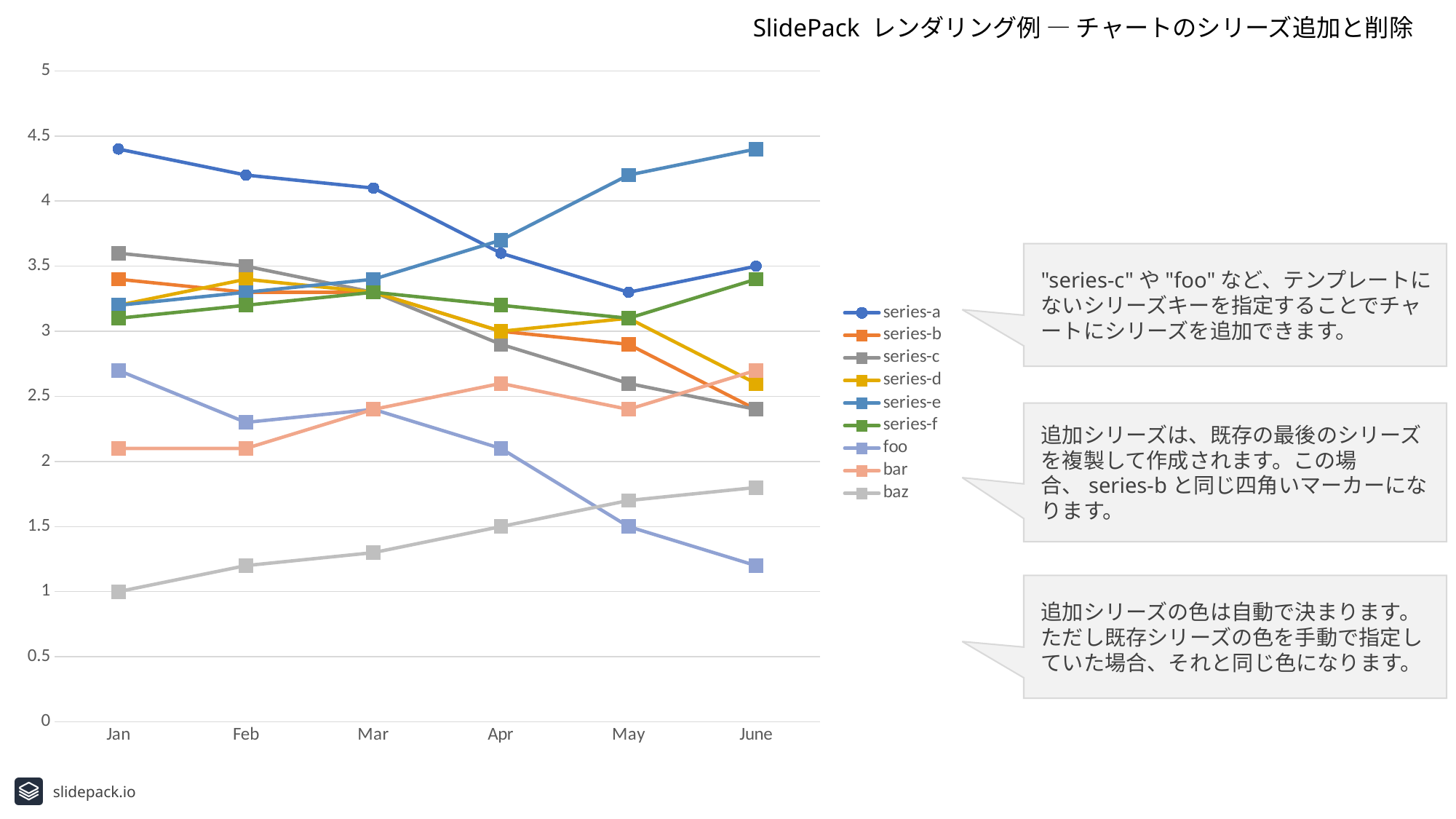
How many series does the legend list? 9 Is the value for bar in Jan greater or less than 2.5? less Do the values for baz rise or fall from Jan to June? rise Which series has the highest value in June? series-e Is the value for series-a in Jan greater or less than 4? greater What kind of chart is shown on the slide? line chart Which series has the lowest value in June? foo Is the value for baz in June greater or less than 2? less Which series has the highest value in Jan? series-a How many categories are on the x axis? 6 Do the values for foo rise or fall from Jan to June? fall Which is larger in June, series-a or series-e? series-e